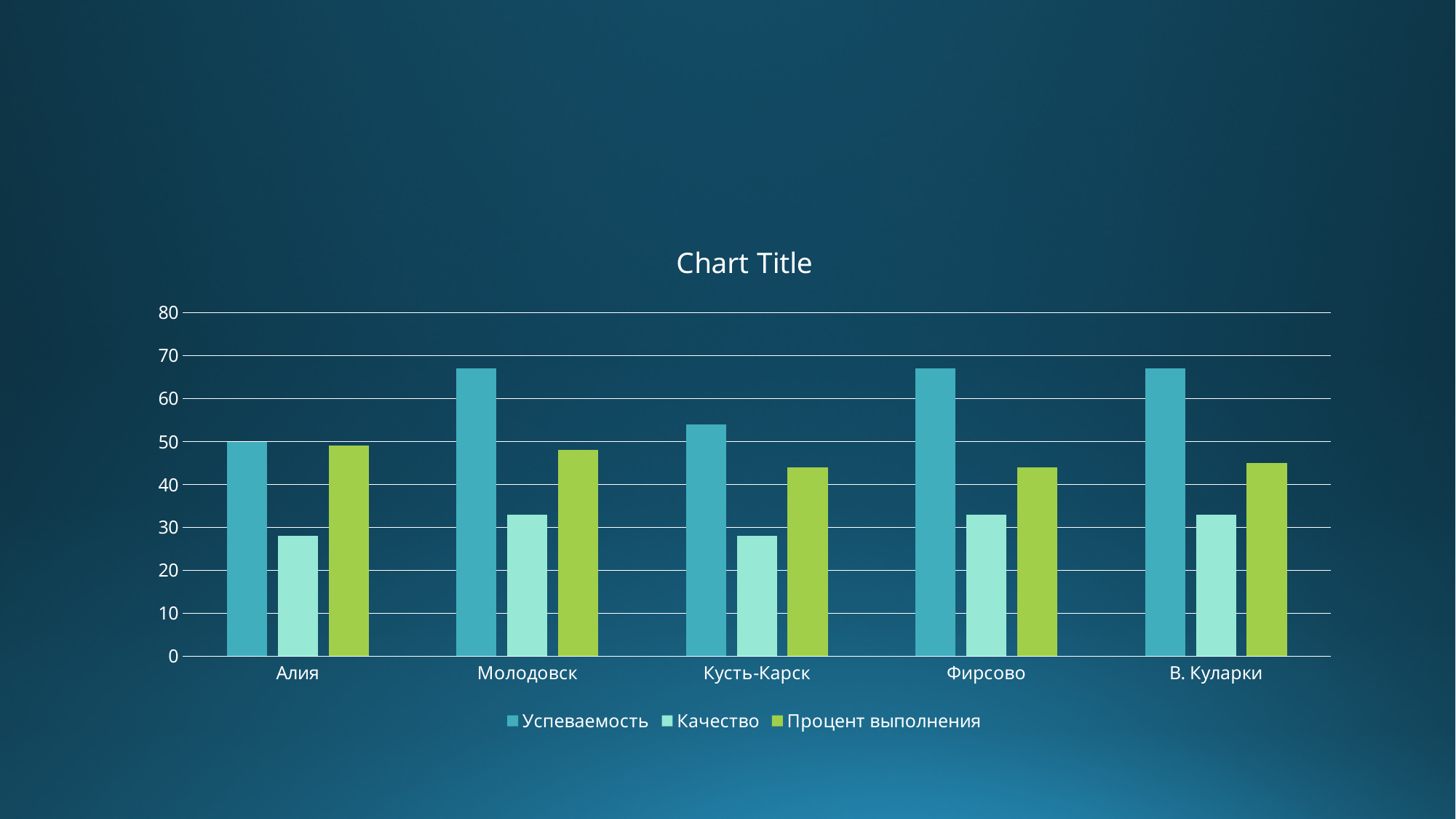
Is the Процент выполнения value for Фирсово greater or less than 40? greater What is the title of the chart? Chart Title What kind of chart is shown on the slide? bar chart Is the Качество value for Кусть-Карск greater or less than 30? less Which category has the lowest value for Успеваемость? Алия How many categories are shown on the x axis? 5 For Алия, which is larger: Успеваемость or Качество? Успеваемость How many series does the legend list? 3 Is the Успеваемость value for В. Куларки greater or less than 60? greater Which has the larger Успеваемость value: Молодовск or Кусть-Карск? Молодовск Which series is shown in green in the legend? Процент выполнения